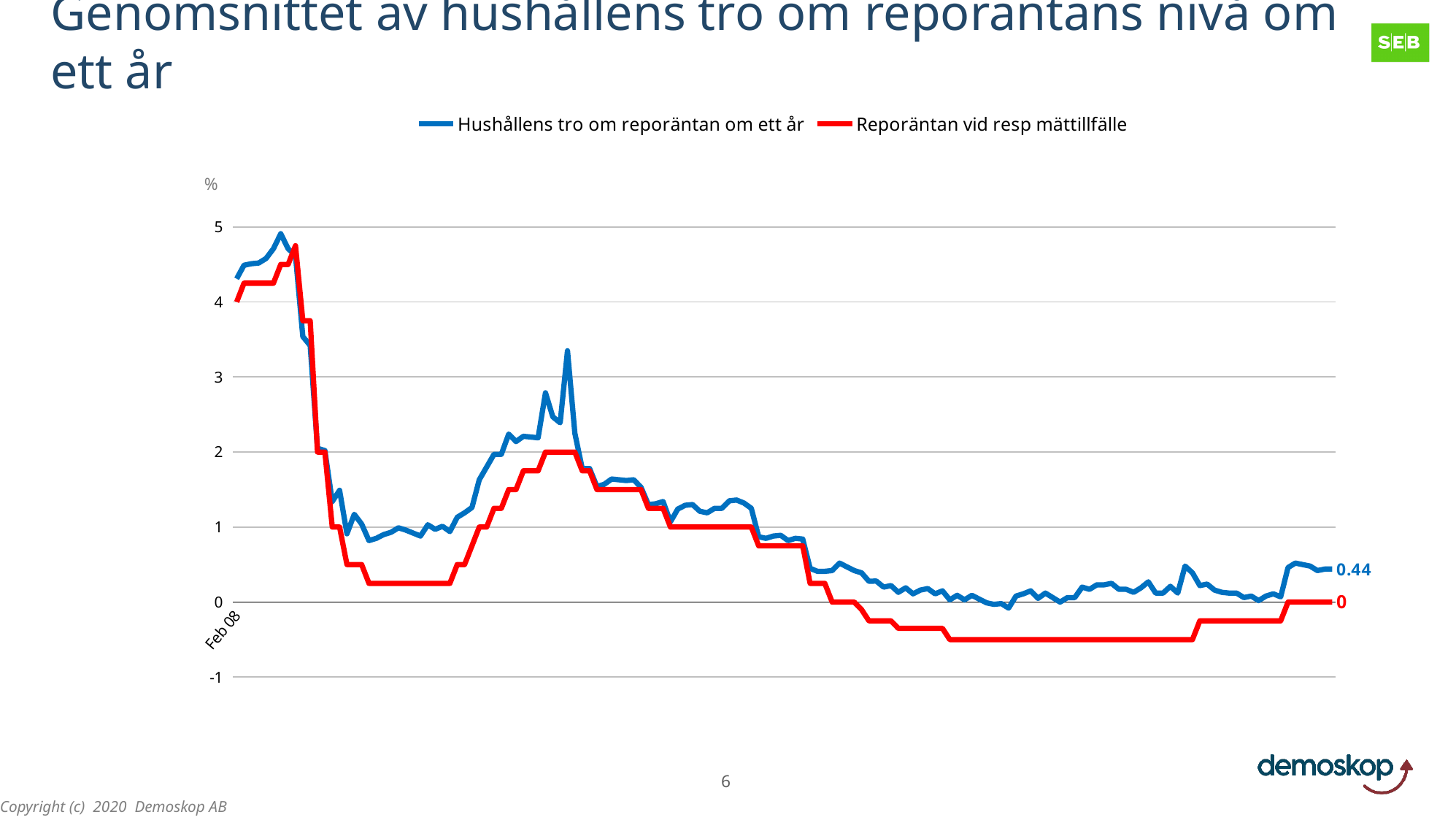
At the end of the chart, which series has the higher value? Hushållens tro om reporäntan om ett år Is the value for 'Hushållens tro om reporäntan om ett år' at Feb 08 greater or less than 4? greater How many series does the legend list? 2 What kind of chart is shown on the slide? line chart What is the difference between the final labelled values of the two series? 0.44 Overall, does the 'Hushållens tro om reporäntan om ett år' line rise or fall from Feb 08 to the end of the chart? fall Is the value for 'Reporäntan vid resp mättillfälle' at Feb 08 greater or less than 3? greater What is the final labelled value of the series 'Reporäntan vid resp mättillfälle'? 0 Which colour is used for the series 'Reporäntan vid resp mättillfälle'? red What is the final labelled value of the series 'Hushållens tro om reporäntan om ett år'? 0.44 Is the highest point of the 'Hushållens tro om reporäntan om ett år' line greater or less than 4? greater What unit is shown on the vertical axis of the chart? %